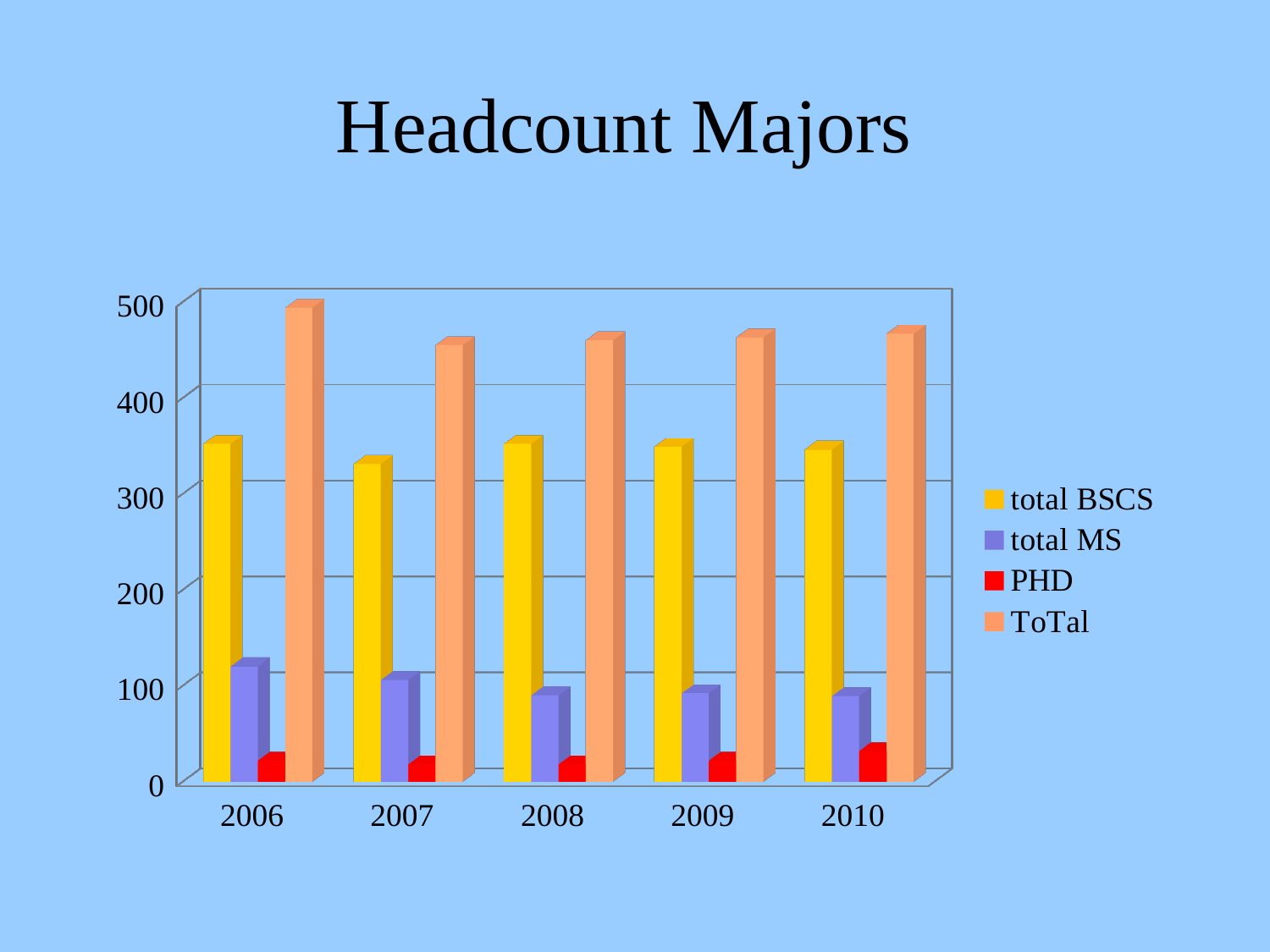
Is the total MS value for 2008 greater or less than 100? less How many series does the legend list? 4 Which colour represents the PHD series in the legend? red What kind of chart is shown on the slide? bar chart Is the ToTal value for 2006 greater or less than 400? greater Which is larger in 2006, total BSCS or total MS? total BSCS In which year is the ToTal bar highest? 2006 In which year is the PHD bar highest? 2010 How many years are shown on the x axis? 5 In which year is the total MS bar highest? 2006 What is the title of the chart? Headcount Majors In which year is the total BSCS bar lowest? 2007